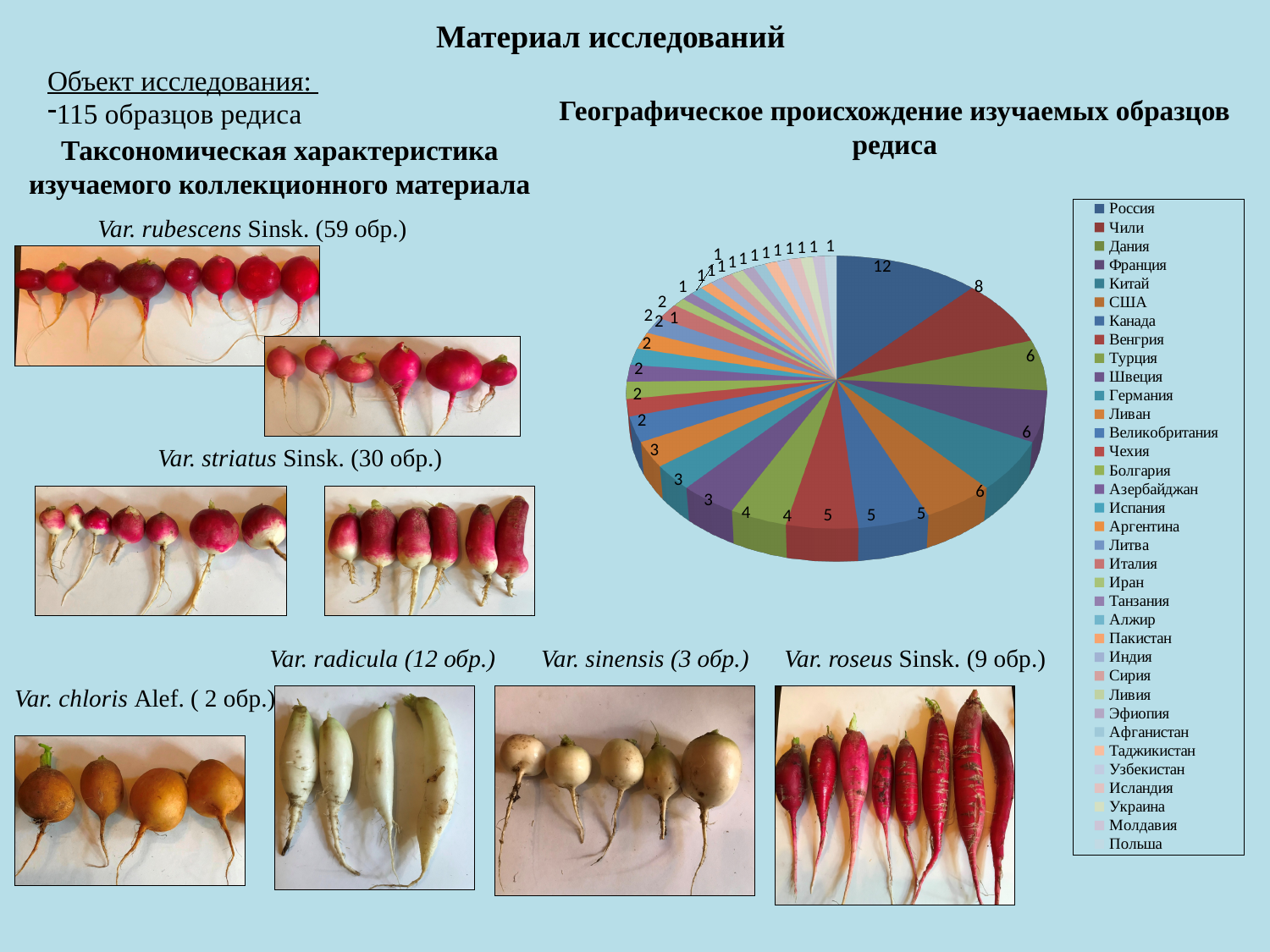
In the pie chart, how many samples come from Дания? 6 In the pie chart, how many samples come from Турция? 4 In the pie chart, how many samples come from Чили? 8 What is the difference between the number of samples from Россия and from Чили in the pie chart? 4 What kind of chart is shown under the title 'Географическое происхождение изучаемых образцов редиса'? pie chart In the pie chart, how many samples come from Россия? 12 In the pie chart, how many samples come from США? 5 What is the title of the pie chart on the slide? Географическое происхождение изучаемых образцов редиса What is the first country listed in the legend of the pie chart? Россия Which country has the largest slice in the pie chart? Россия In the pie chart, which has more samples: Россия or Китай? Россия In the pie chart, which has more samples: Чили or Дания? Чили